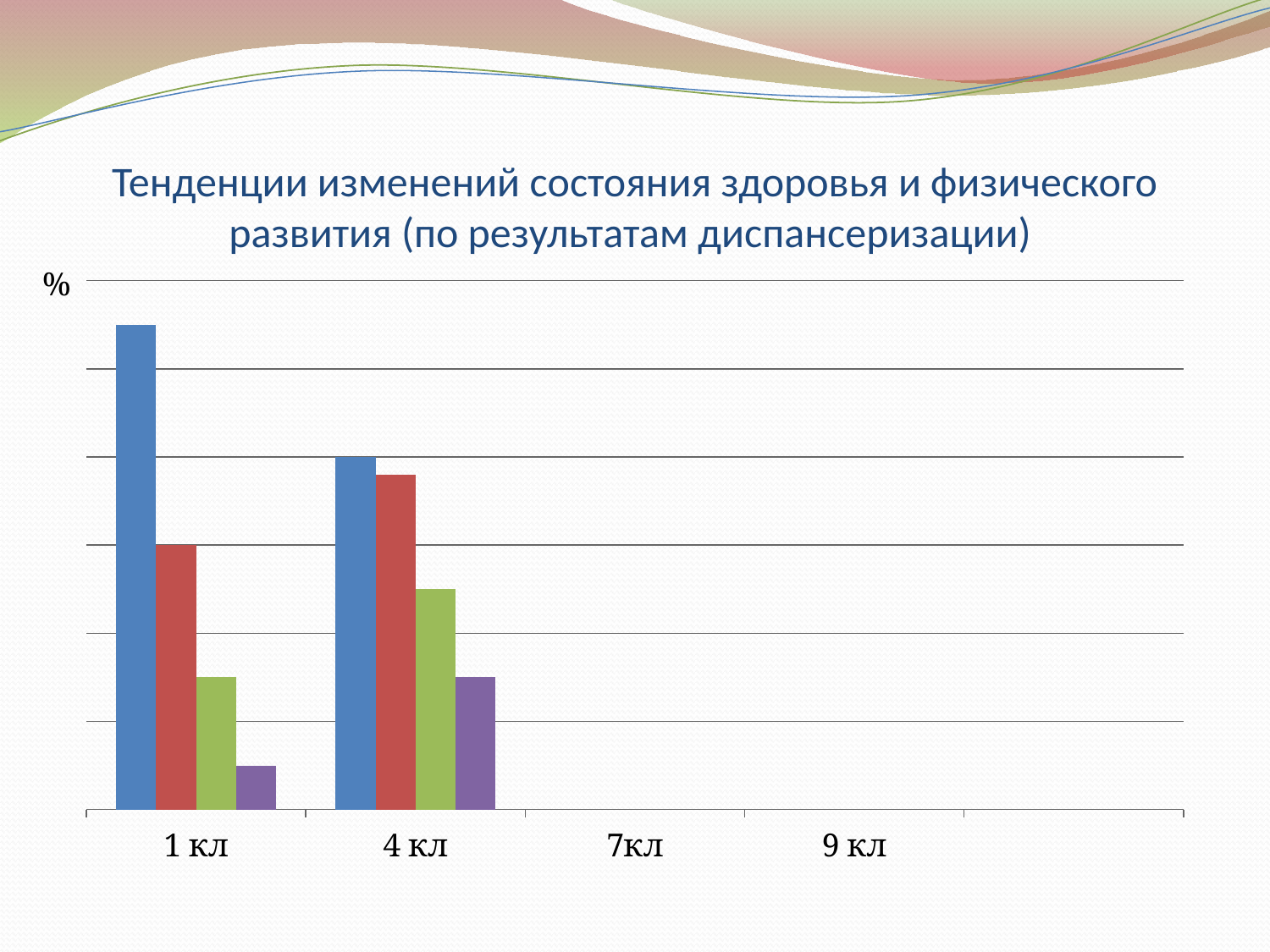
Is the blue bar taller for 1 кл or for 4 кл? 1 кл Within the 4 кл group, which coloured bar is the shortest? purple What is the title of the chart on the slide? Тенденции изменений состояния здоровья и физического развития (по результатам диспансеризации) Is the red bar taller for 1 кл or for 4 кл? 4 кл Which categories on the x axis have no bars plotted? 7кл and 9 кл Is the green bar taller for 1 кл or for 4 кл? 4 кл What unit label is shown at the top of the vertical axis? % Within the 1 кл group, which coloured bar is the shortest? purple What kind of chart is shown on the slide? bar chart Which category has the tallest bar in the chart? 1 кл How many categories are labelled on the x axis of the chart? 4 Within the 1 кл group, which coloured bar is the tallest? blue